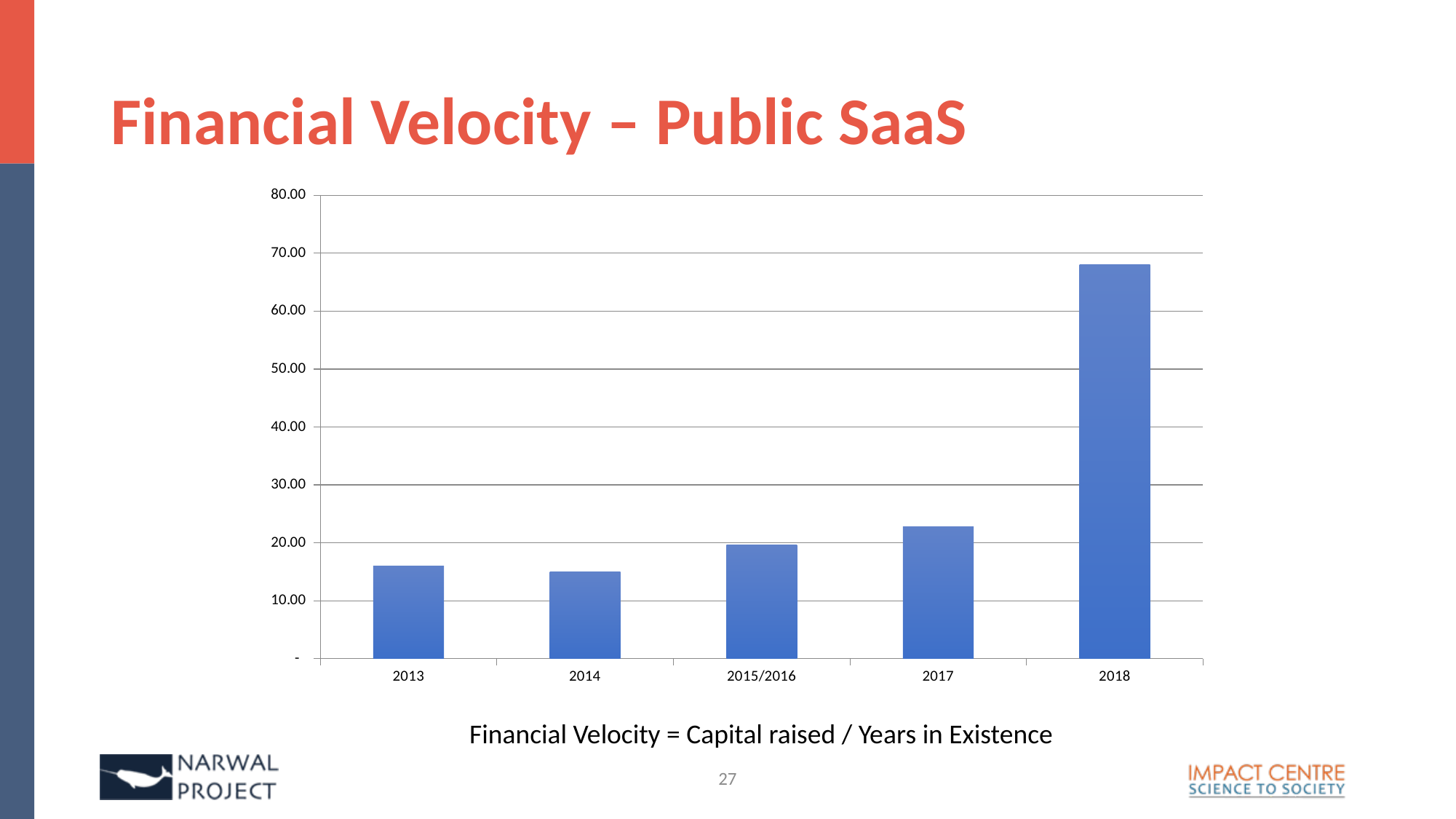
Which is larger, the value for 2017 or the value for 2018? 2018 Is the value for 2014 greater or less than 20.00? less Which category has the highest value in the chart? 2018 Do the values generally rise or fall from 2013 to 2018? rise Is the value for 2015/2016 greater or less than 10.00? greater Is the value for 2018 greater or less than 60.00? greater What is the title of the slide containing the chart? Financial Velocity – Public SaaS Which is larger, the value for 2014 or the value for 2017? 2017 What kind of chart is shown on the slide? bar chart How many categories are shown on the x axis of the chart? 5